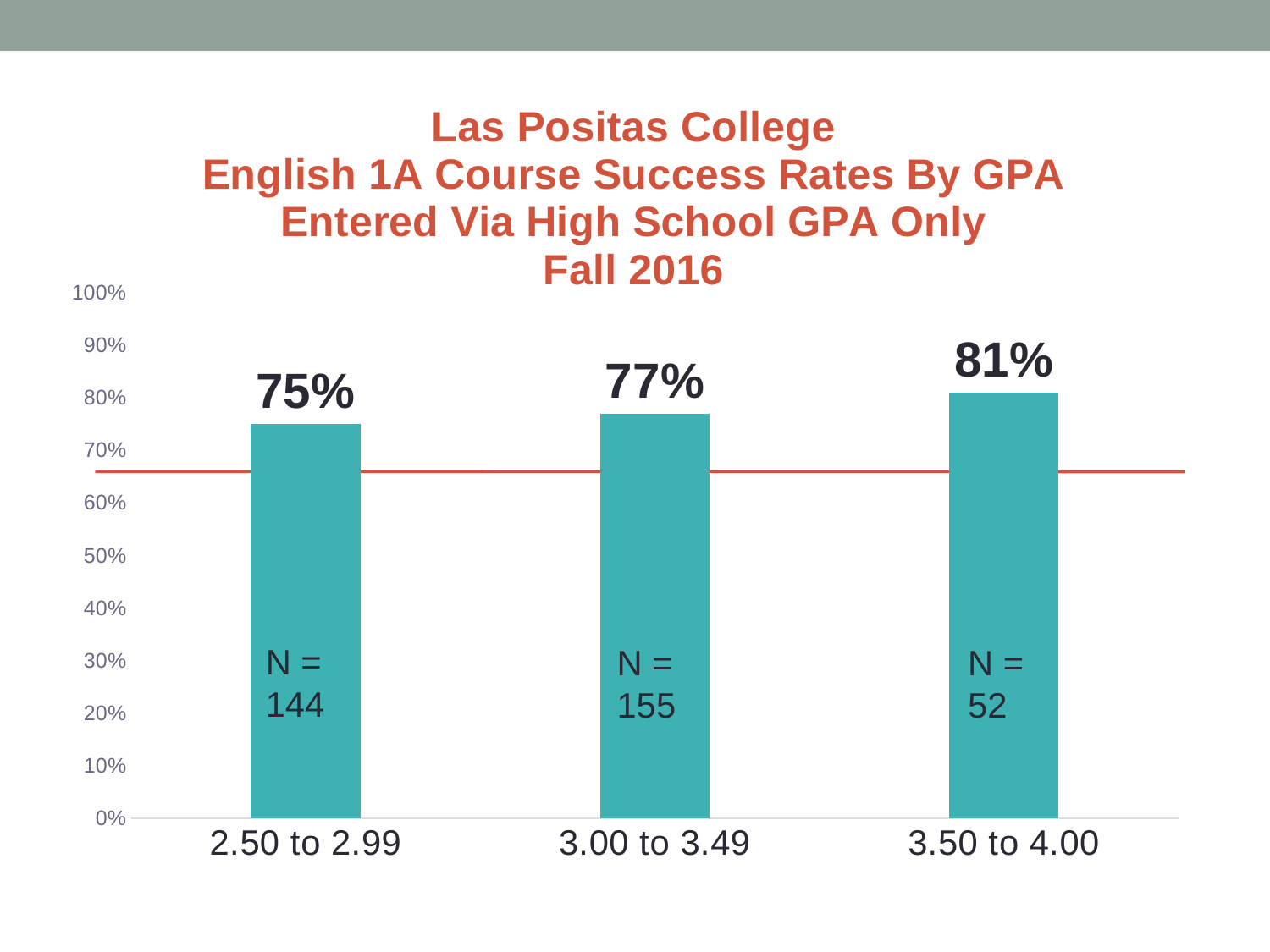
What kind of chart is shown on the slide? Bar chart What is the N (number of students) for the 3.00 to 3.49 GPA group? 155 What is the English 1A course success rate for students with a GPA of 3.50 to 4.00? 81% Do the success rates rise or fall as GPA increases along the x axis? Rise What is the English 1A course success rate for students with a GPA of 2.50 to 2.99? 75% What is the N (number of students) for the 3.50 to 4.00 GPA group? 52 How many GPA groups are shown on the chart? 3 Which GPA group has the lowest course success rate? 2.50 to 2.99 Which group has a higher success rate, 3.00 to 3.49 or 2.50 to 2.99? 3.00 to 3.49 What is the difference in success rate between the 3.50 to 4.00 group and the 2.50 to 2.99 group? 6 percentage points What is the English 1A course success rate for students with a GPA of 3.00 to 3.49? 77% Which GPA group has the highest course success rate? 3.50 to 4.00